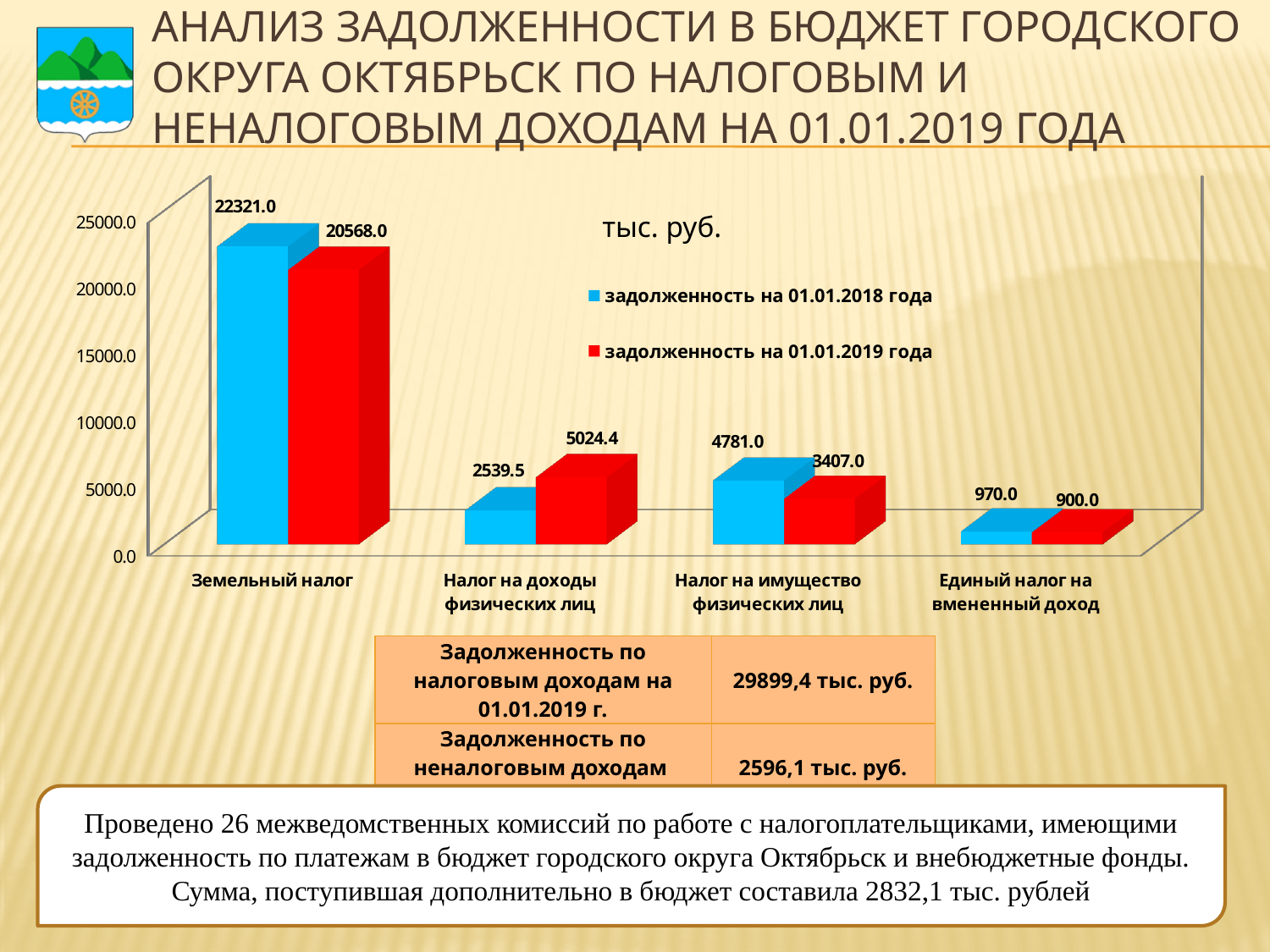
What is the difference between the 01.01.2018 and 01.01.2019 values for Земельный налог? 1753.0 How many categories are shown on the x axis of the chart? 4 What is the value for Налог на доходы физических лиц in the series задолженность на 01.01.2019 года? 5024.4 Which category has the highest value in the series задолженность на 01.01.2019 года? Земельный налог What is the value for Налог на имущество физических лиц in the series задолженность на 01.01.2018 года? 4781.0 Which category has the lowest value in the series задолженность на 01.01.2018 года? Единый налог на вмененный доход What is the value for Единый налог на вмененный доход in the series задолженность на 01.01.2019 года? 900.0 What kind of chart is shown on the slide? bar chart What is the value for Земельный налог in the series задолженность на 01.01.2018 года? 22321.0 Is the value for Налог на имущество физических лиц in the series задолженность на 01.01.2019 года greater or less than 5000.0? less For Налог на доходы физических лиц, which is larger: the value for задолженность на 01.01.2018 года or for задолженность на 01.01.2019 года? задолженность на 01.01.2019 года How many series does the chart legend list? 2